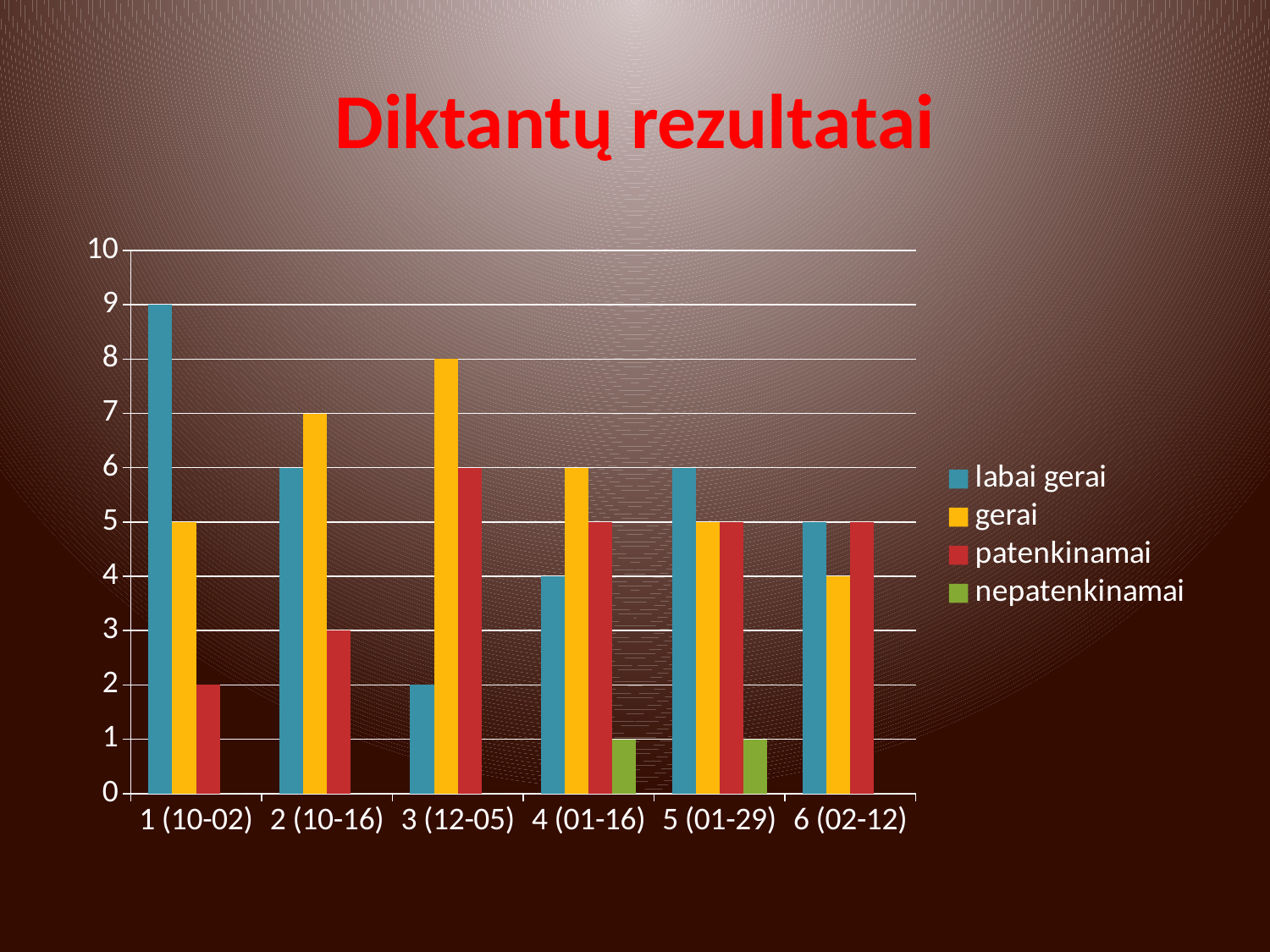
How many categories are shown on the x axis? 6 What is the title of the chart? Diktantų rezultatai Which category has the highest 'labai gerai' value? 1 (10-02) What is the value of 'patenkinamai' for category 2 (10-16)? 3 Which category has the lowest 'labai gerai' value? 3 (12-05) For category 4 (01-16), which is larger: 'gerai' or 'labai gerai'? gerai What is the difference between the 'gerai' value and the 'patenkinamai' value for category 1 (10-02)? 3 Which series is shown in green in the legend? nepatenkinamai How many series does the legend list? 4 What is the value of 'labai gerai' for category 1 (10-02)? 9 What kind of chart is shown on the slide? bar chart What is the value of 'gerai' for category 3 (12-05)? 8